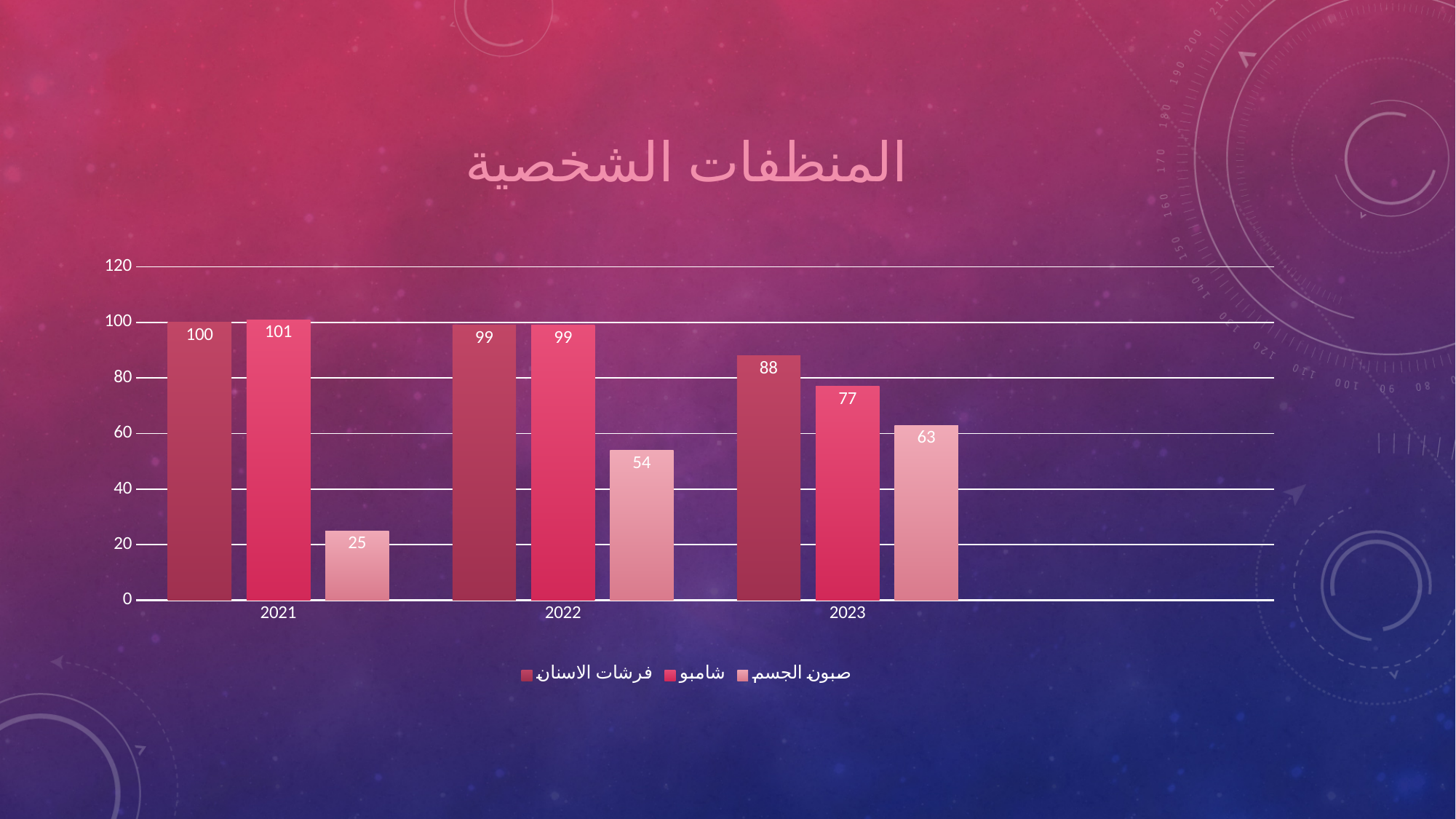
What is the value for صبون الجسم in 2022? 54 What is the title of the chart? المنظفات الشخصية How many series does the legend list? 3 What is the value for فرشات الاسنان in 2023? 88 What is the value for شامبو in 2021? 101 Does the value for فرشات الاسنان rise or fall from 2021 to 2023? fall What kind of chart is shown on the slide? bar chart In which year is the value for فرشات الاسنان the highest? 2021 Which is larger in 2023: the value for فرشات الاسنان or the value for صبون الجسم? فرشات الاسنان How many years are shown on the x axis? 3 In which year is the value for صبون الجسم the lowest? 2021 What is the difference between the شامبو value in 2021 and the شامبو value in 2023? 24